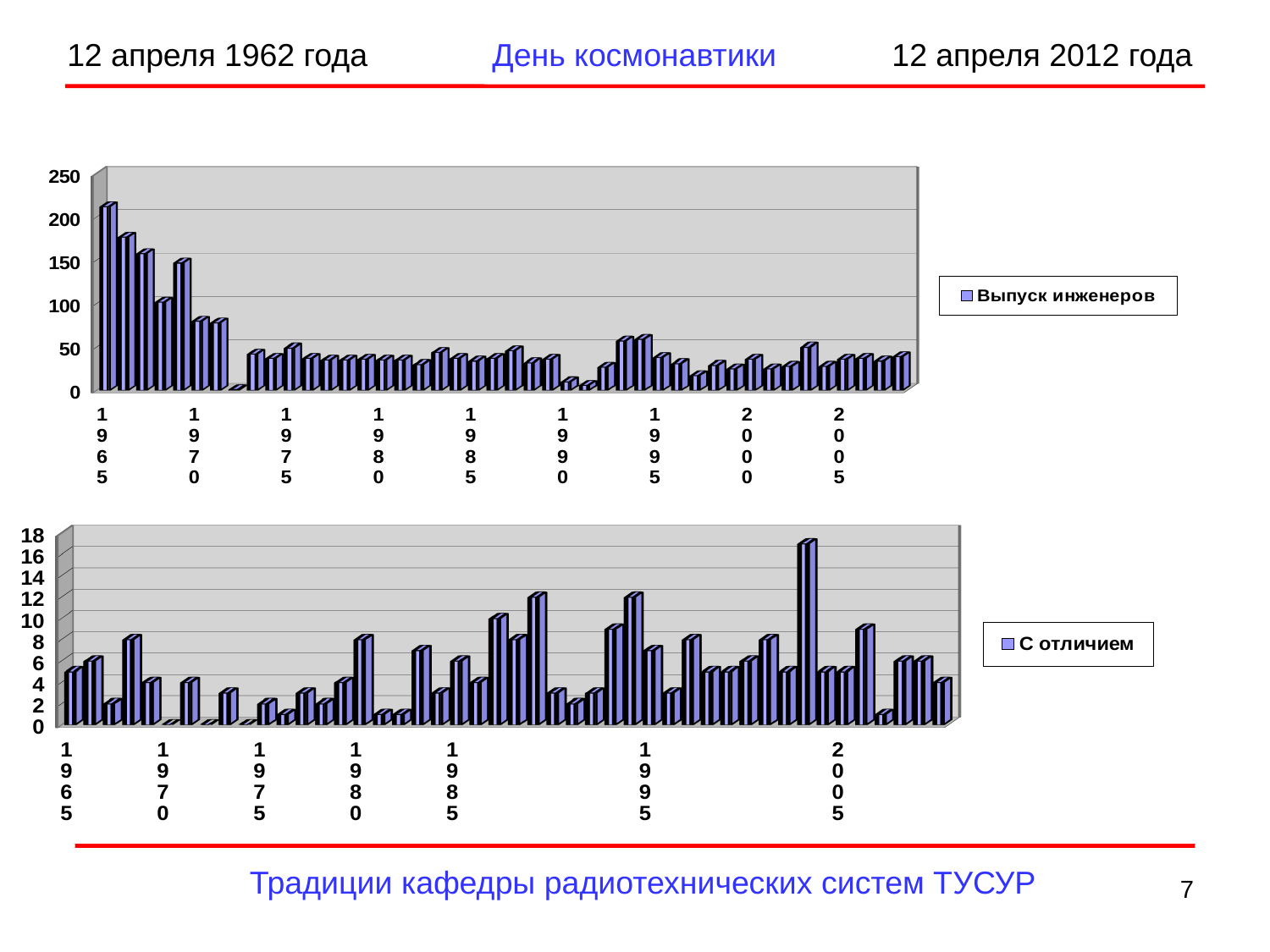
What is the legend entry of the bottom chart? С отличием What is the legend entry of the top chart? Выпуск инженеров In the top chart (Выпуск инженеров), is the value for 1965 greater or less than 200? greater In the bottom chart (С отличием), is the value for 1970 greater or less than 10? less What kind of chart is the bottom chart on the slide? bar chart In the top chart (Выпуск инженеров), which is larger, the value for 1965 or the value for 1990? 1965 In the top chart (Выпуск инженеров), which year has the highest value? 1965 In the top chart (Выпуск инженеров), is the value for 1990 greater or less than 50? less What kind of chart is the top chart on the slide? bar chart How many series does the legend of the top chart list? 1 In the top chart (Выпуск инженеров), do the values rise or fall from 1965 to 1970? fall